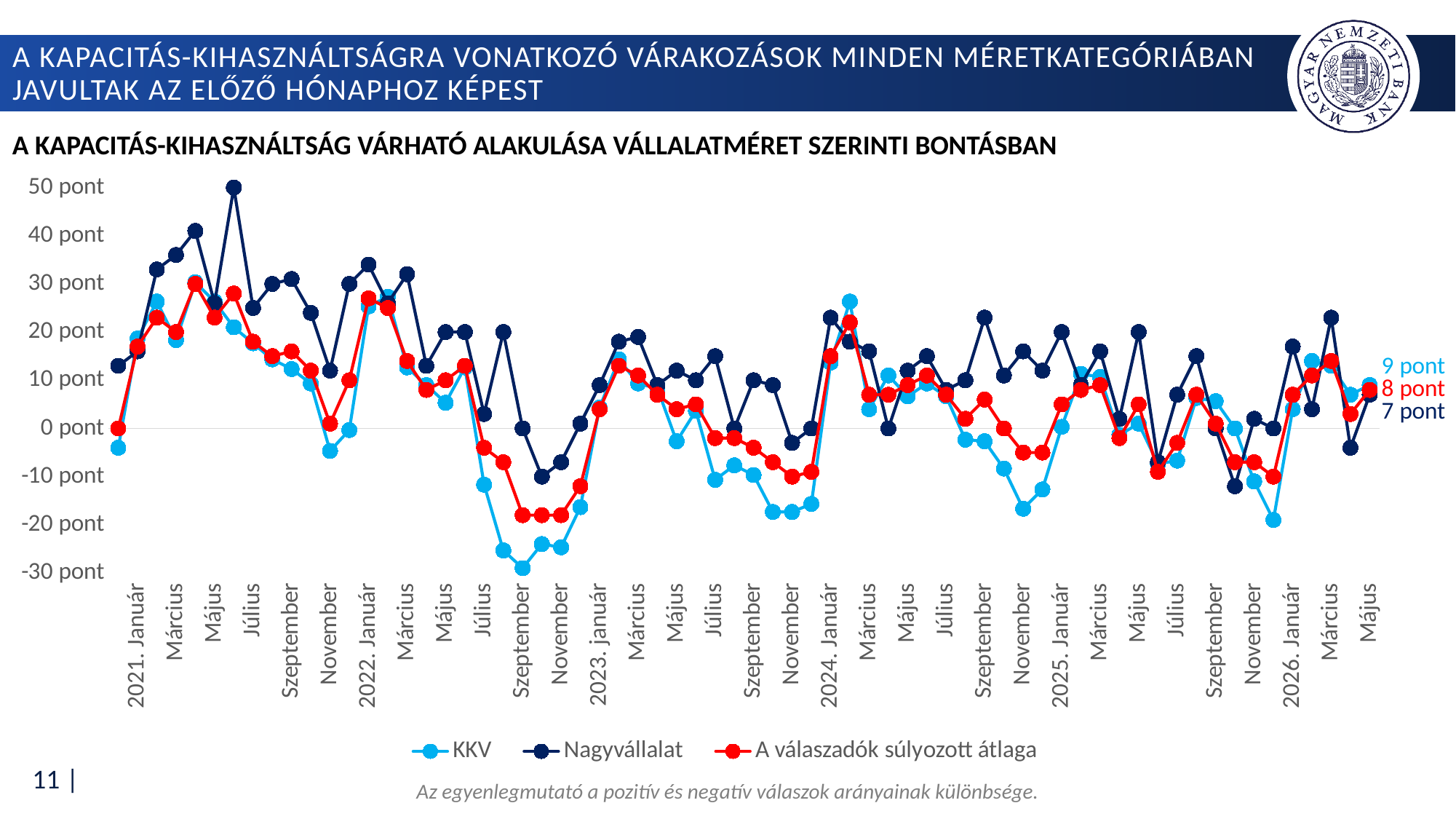
What is the latest value shown for the KKV series? 9 pont Does the Nagyvállalat series rise or fall between 2021. Január and Július 2021? Rise Which series has the lowest value at the end of the chart (Május 2026)? Nagyvállalat Is the KKV value in Szeptember 2022 greater or less than -20 pont? less Which series has the highest value at the end of the chart (Május 2026)? KKV How many series does the legend list? 3 At the end of the chart, which is larger: the KKV value or the weighted average (A válaszadók súlyozott átlaga) value? KKV What is the difference between the latest KKV value and the latest Nagyvállalat value? 2 pont What is the latest value shown for the Nagyvállalat series? 7 pont What kind of chart is shown on the slide? Line chart Is the Nagyvállalat value in Július 2021 greater or less than 40 pont? less What is the latest value shown for the 'A válaszadók súlyozott átlaga' series? 8 pont